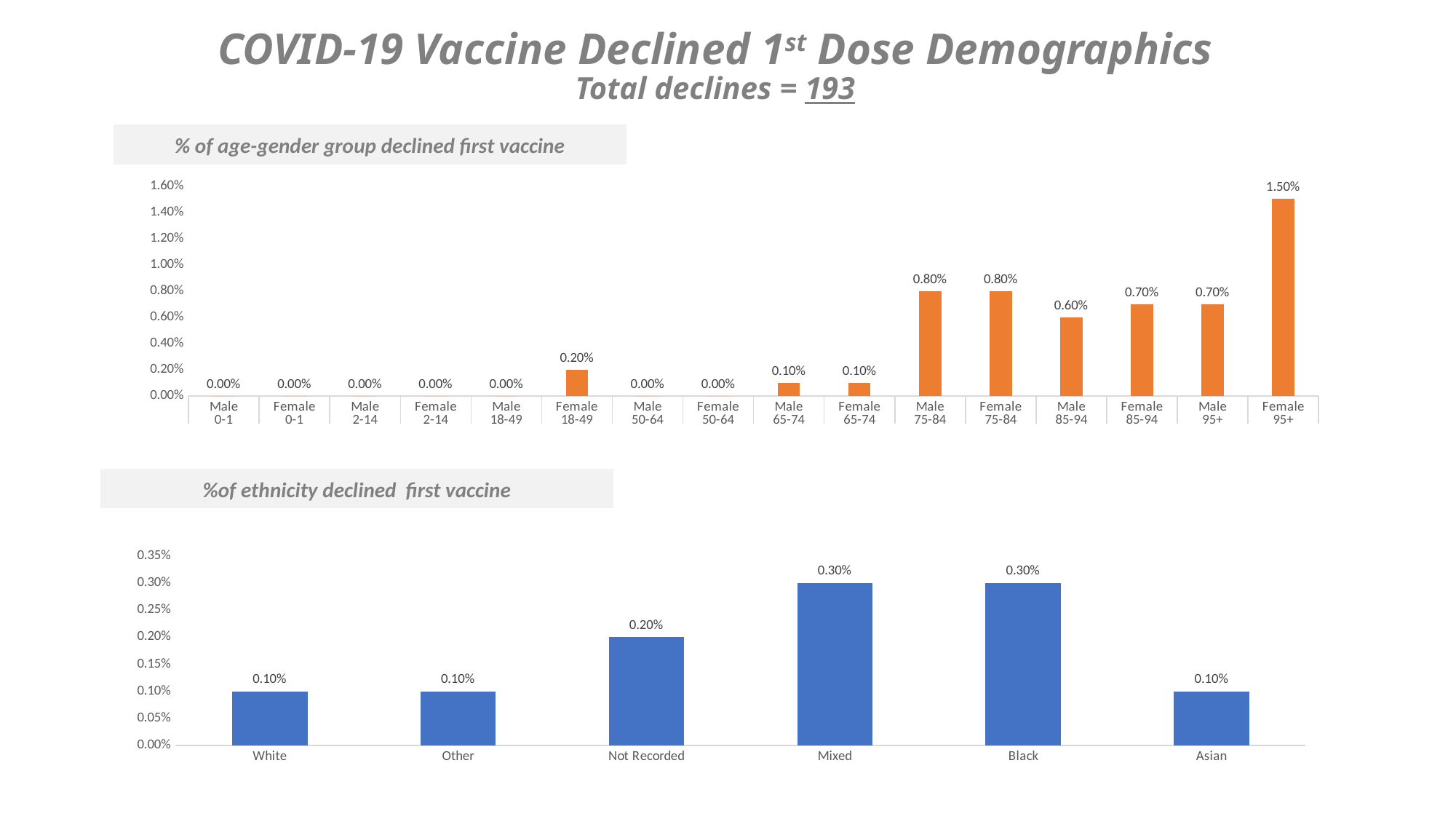
In the '%of ethnicity declined first vaccine' chart, what is the difference between Mixed and White? 0.20% How many categories are shown in the '%of ethnicity declined first vaccine' chart? 6 In the '%of ethnicity declined first vaccine' chart, what is the value for Not Recorded? 0.20% In the '% of age-gender group declined first vaccine' chart, what is the value for Female 95+? 1.50% In the '% of age-gender group declined first vaccine' chart, which is larger, Female 18-49 or Male 65-74? Female 18-49 What is the total number of declines stated in the slide subtitle? 193 In the '% of age-gender group declined first vaccine' chart, what is the value for Male 85-94? 0.60% In the '% of age-gender group declined first vaccine' chart, what is the difference between Female 95+ and Male 75-84? 0.70% In the '% of age-gender group declined first vaccine' chart, which category has the highest value? Female 95+ In the '%of ethnicity declined first vaccine' chart, what is the value for Black? 0.30% What type of chart is the '%of ethnicity declined first vaccine' chart? Bar chart How many categories are shown in the '% of age-gender group declined first vaccine' chart? 16